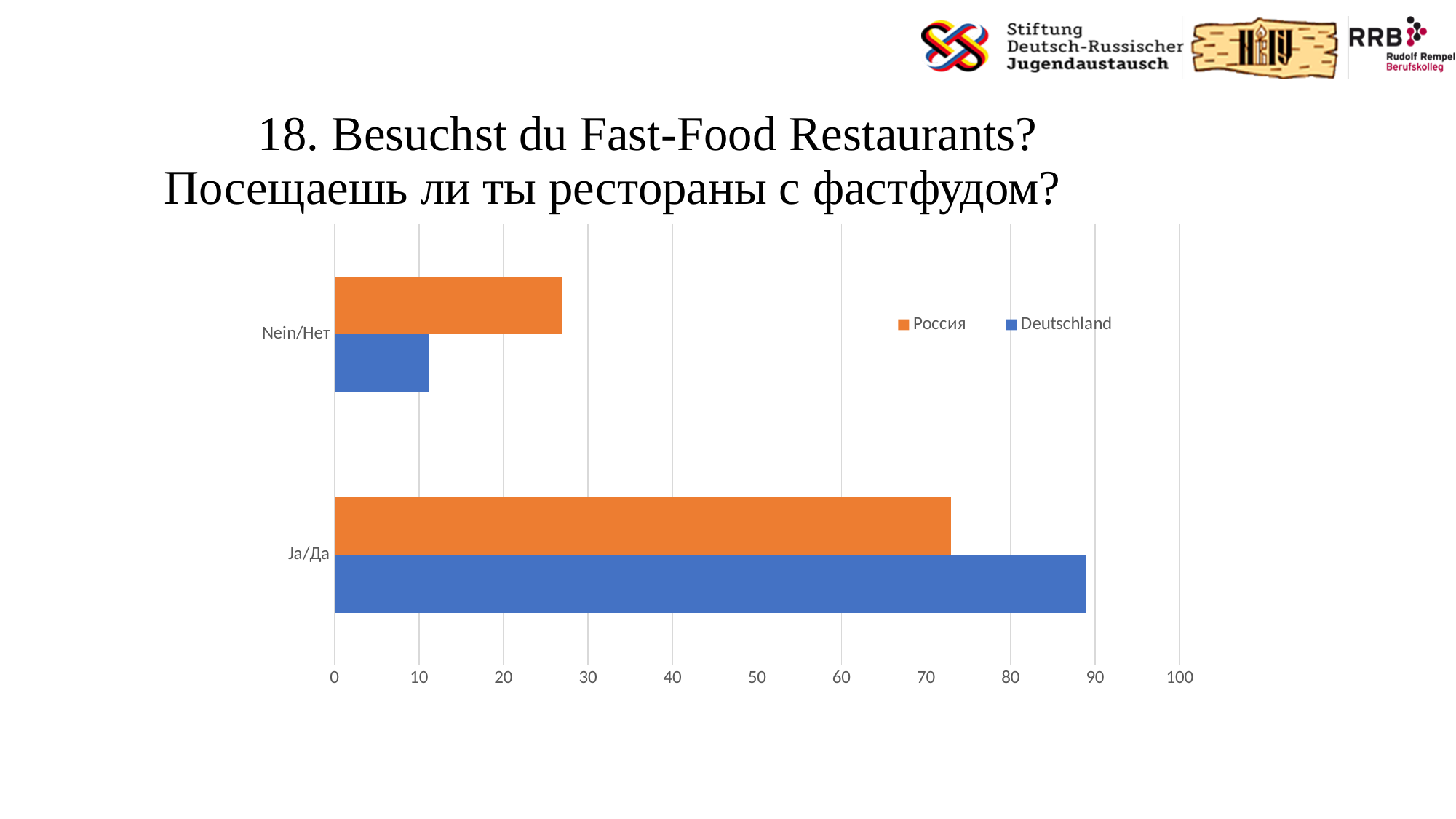
Which series is shown in blue? Deutschland Is the value for Deutschland in the Ja/Да category greater or less than 80? greater What kind of chart is shown on the slide? bar chart How many categories are shown on the vertical axis? 2 How many series does the legend list? 2 In the Nein/Нет category, which series has the larger value, Россия or Deutschland? Россия Is the value for Россия in the Nein/Нет category greater or less than 30? less Is the value for Deutschland in the Nein/Нет category greater or less than 20? less Which bar is the longest in the chart? Deutschland, Ja/Да In the Ja/Да category, which series has the larger value, Россия or Deutschland? Deutschland Which series is shown in orange? Россия